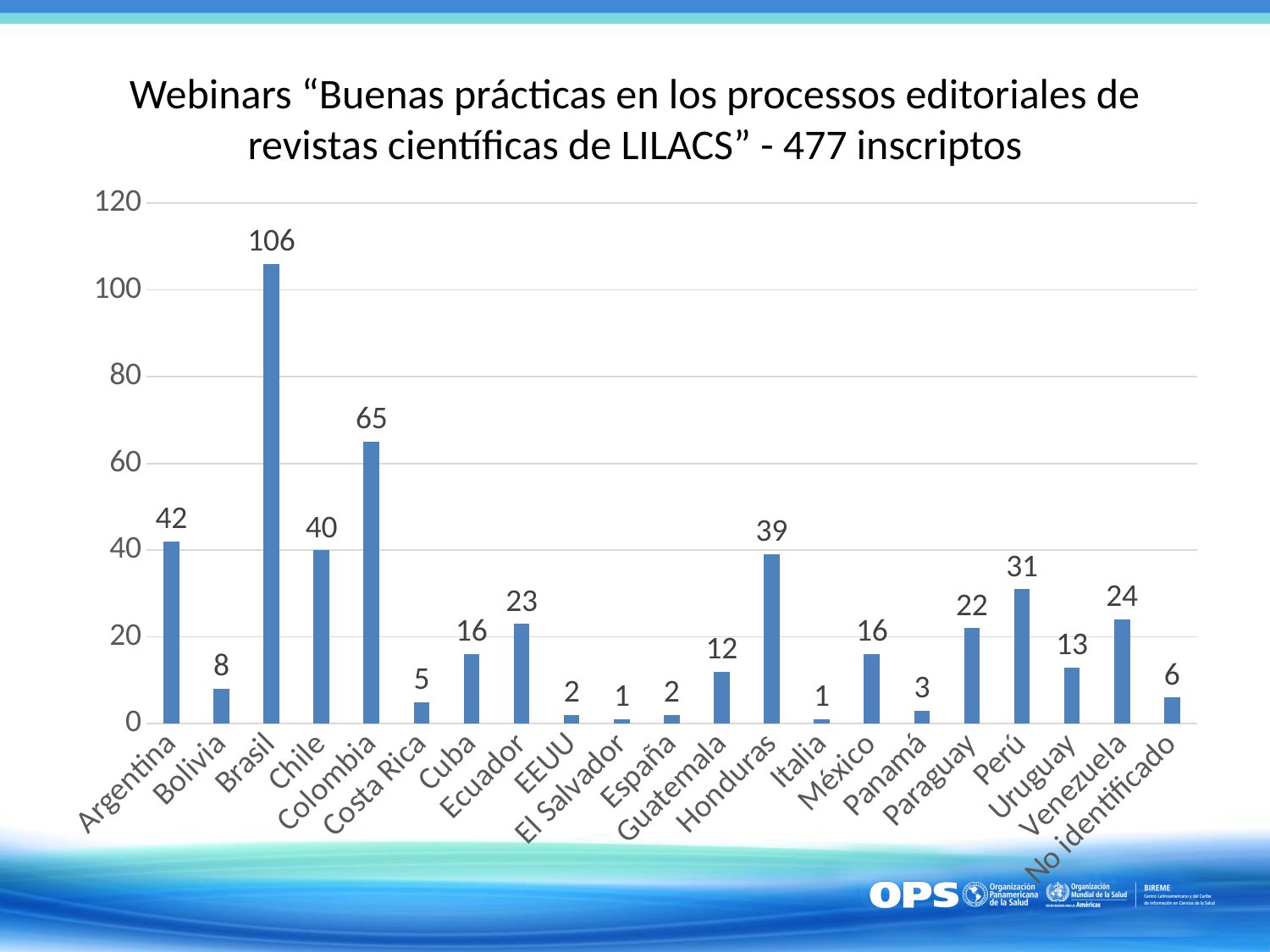
Which has a larger value, Paraguay or Ecuador? Ecuador Which country has the highest value in the chart? Brasil What is the difference between the values for Colombia and Chile? 25 What is the value shown for the 'No identificado' category? 6 How many registrants does the chart show for Brasil? 106 What is the difference between the values for Argentina and Perú? 11 What is the value shown for Venezuela? 24 What type of chart is shown on the slide? Bar chart What is the value shown for Honduras? 39 How many categories are shown on the x axis of the chart? 21 Which has a larger value, Uruguay or Guatemala? Uruguay According to the slide title, how many total registrants ('inscriptos') were there for the webinars? 477